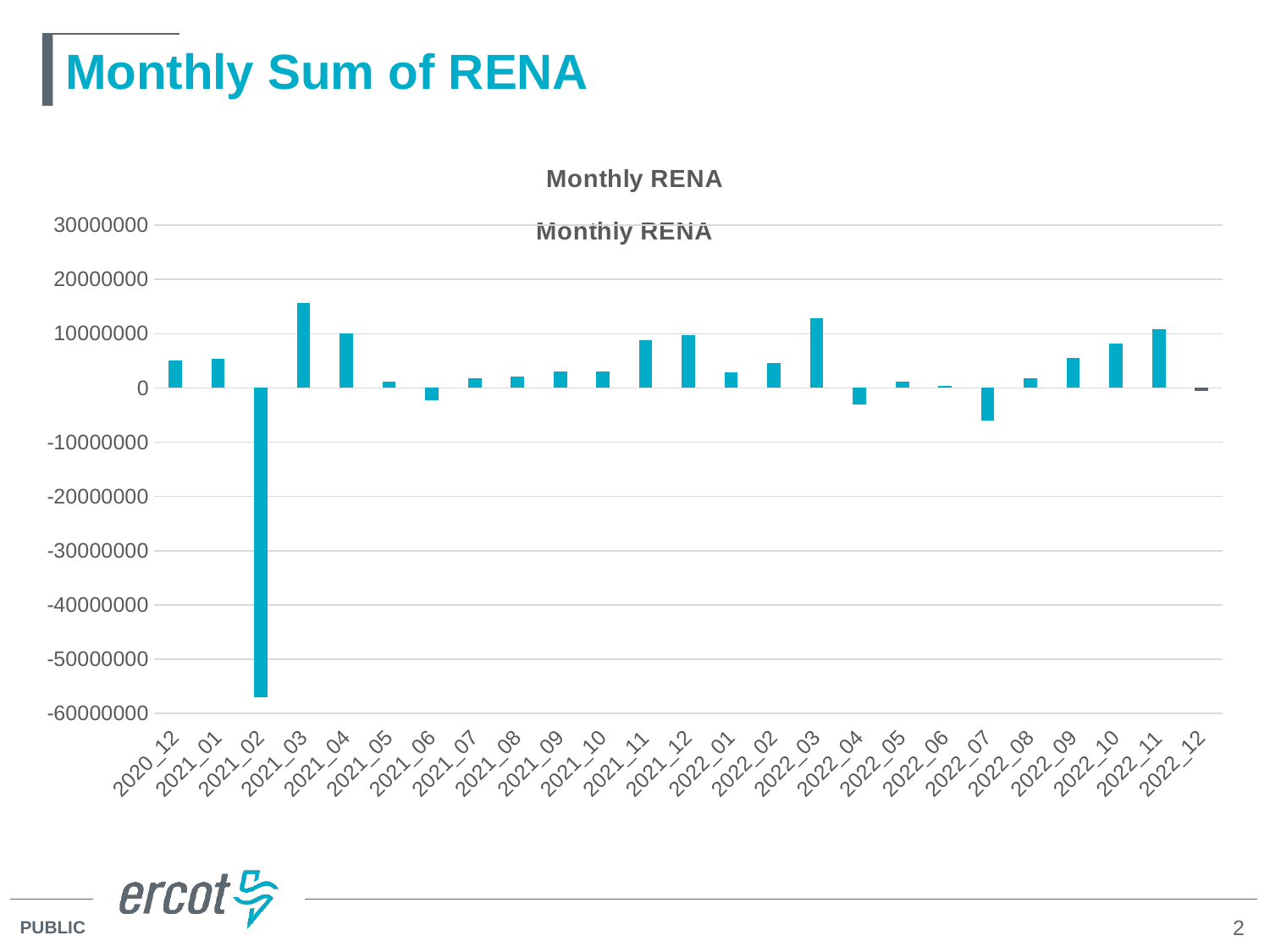
What kind of chart is shown on the slide? bar chart Is the value for 2021_02 greater or less than -50000000? less Which is larger, the value for 2022_10 or the value for 2022_11? 2022_11 Is the value for 2021_11 greater or less than 10000000? less What is the title of the chart? Monthly RENA How many months are plotted on the x axis of the chart? 25 Is the value for 2021_03 greater or less than 10000000? greater Which is larger, the value for 2021_03 or the value for 2022_03? 2021_03 Which month has the lowest Monthly RENA value? 2021_02 Which month has the highest Monthly RENA value? 2021_03